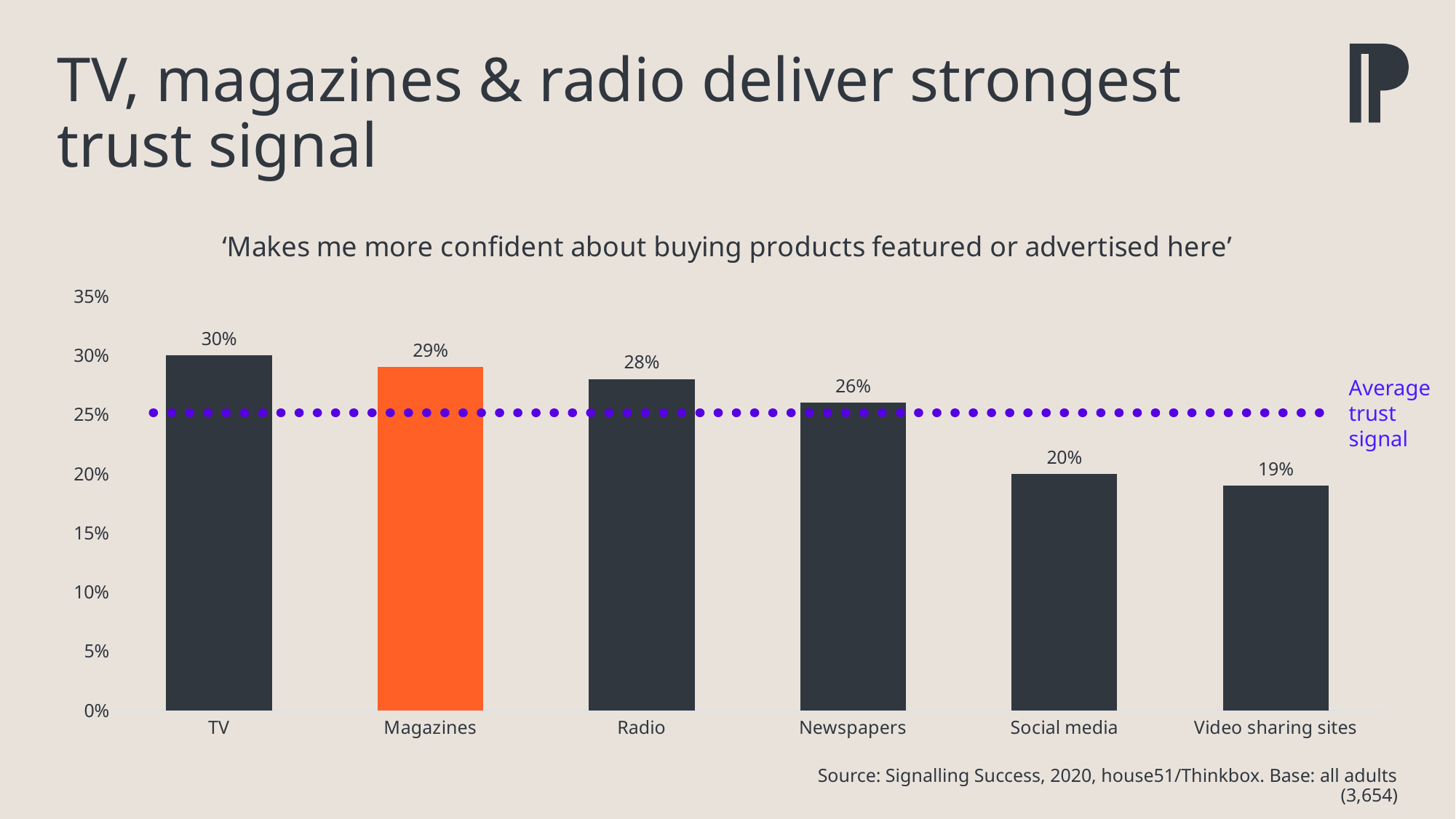
How many categories are shown on the x axis? 6 What is the difference between the values for Radio and Newspapers? 2% Which category has the highest value? TV What is the value for Social media? 20% What is the value for TV? 30% Which is larger, the value for Newspapers or the value for Social media? Newspapers What is the difference between the values for TV and Video sharing sites? 11% What is the value for Magazines? 29% Which bar is highlighted in orange? Magazines Is the value for Radio greater or less than 25%? greater Which category has the lowest value? Video sharing sites What kind of chart is shown on the slide? Bar chart